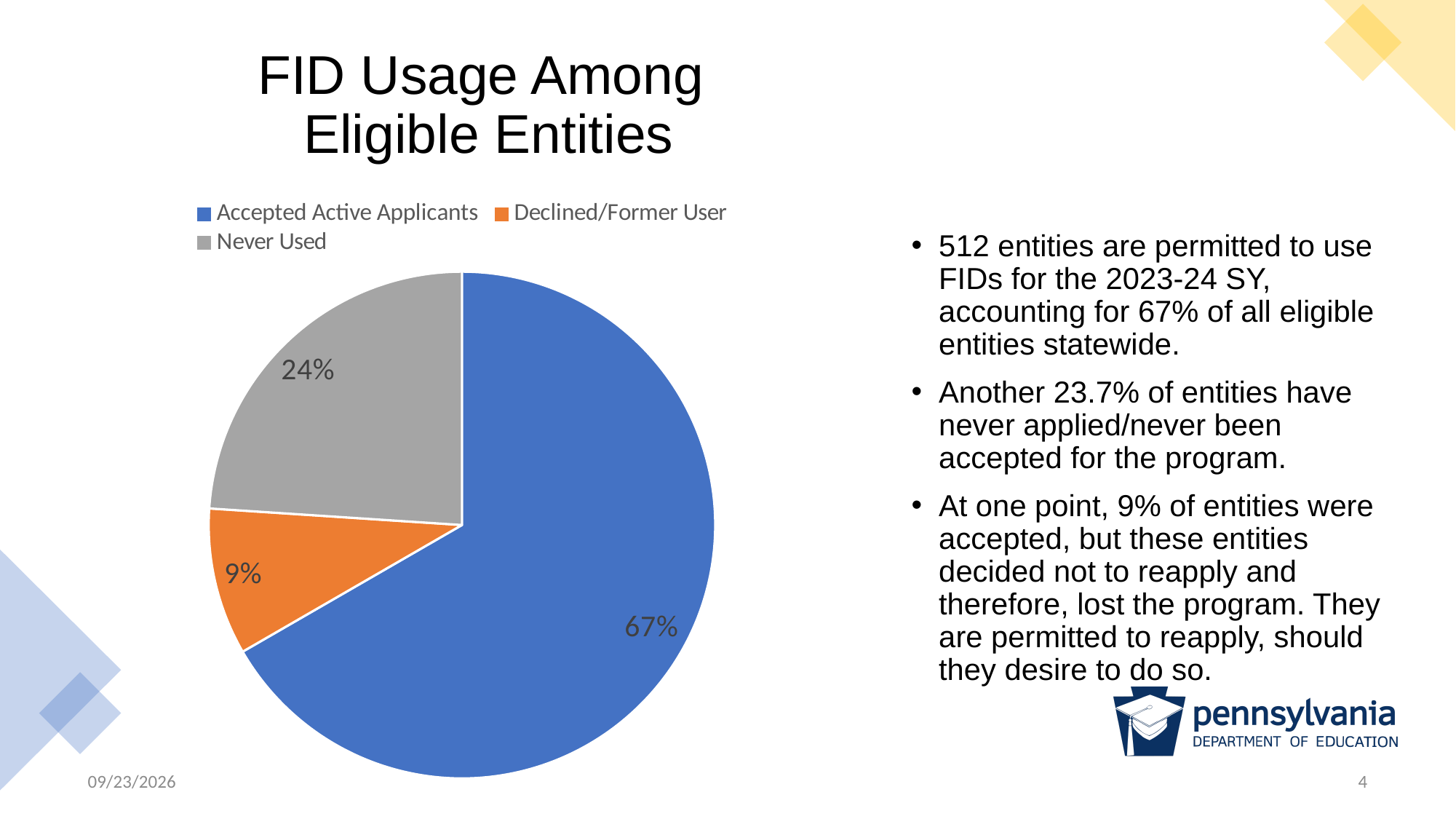
What share of the pie is Never Used? 24% How many entries does the legend list? 3 What is the difference in percentage points between the Never Used slice and the Declined/Former User slice? 15 What share of the pie is Declined/Former User? 9% Which slice is larger: Never Used or Declined/Former User? Never Used What share of the pie is Accepted Active Applicants? 67% What kind of chart is shown on the slide? pie chart What colour is the Never Used slice? gray What is the title of the chart on the slide? FID Usage Among Eligible Entities How many slices does the pie chart have? 3 Which category has the largest slice of the pie? Accepted Active Applicants Which category has the smallest slice of the pie? Declined/Former User